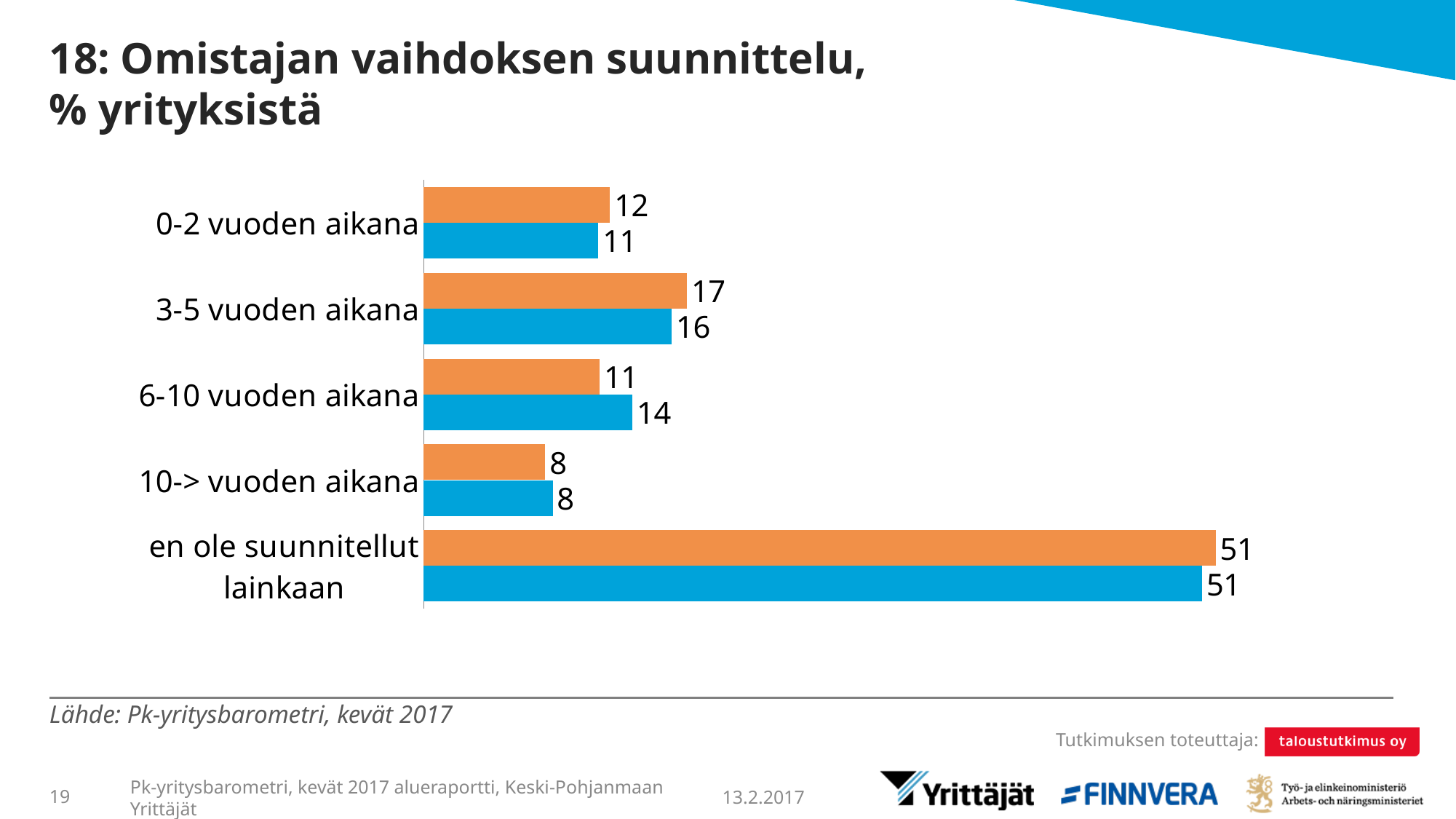
What is the value of the blue bar for "6-10 vuoden aikana"? 14 What is the difference between the orange bars for "3-5 vuoden aikana" and "0-2 vuoden aikana"? 5 Which category has the highest value for the orange bars? en ole suunnitellut lainkaan What is the value of the orange bar for "3-5 vuoden aikana"? 17 What is the value of the blue bar for "0-2 vuoden aikana"? 11 Which is larger for "6-10 vuoden aikana", the orange bar or the blue bar? the blue bar What kind of chart is shown on the slide? bar chart Which category has the lowest value for the blue bars? 10-> vuoden aikana How many categories are shown on the chart? 5 Which is larger, the blue bar for "3-5 vuoden aikana" or the blue bar for "0-2 vuoden aikana"? 3-5 vuoden aikana What is the title of the chart on the slide? 18: Omistajan vaihdoksen suunnittelu, % yrityksistä What is the difference between the orange and blue bars for "6-10 vuoden aikana"? 3